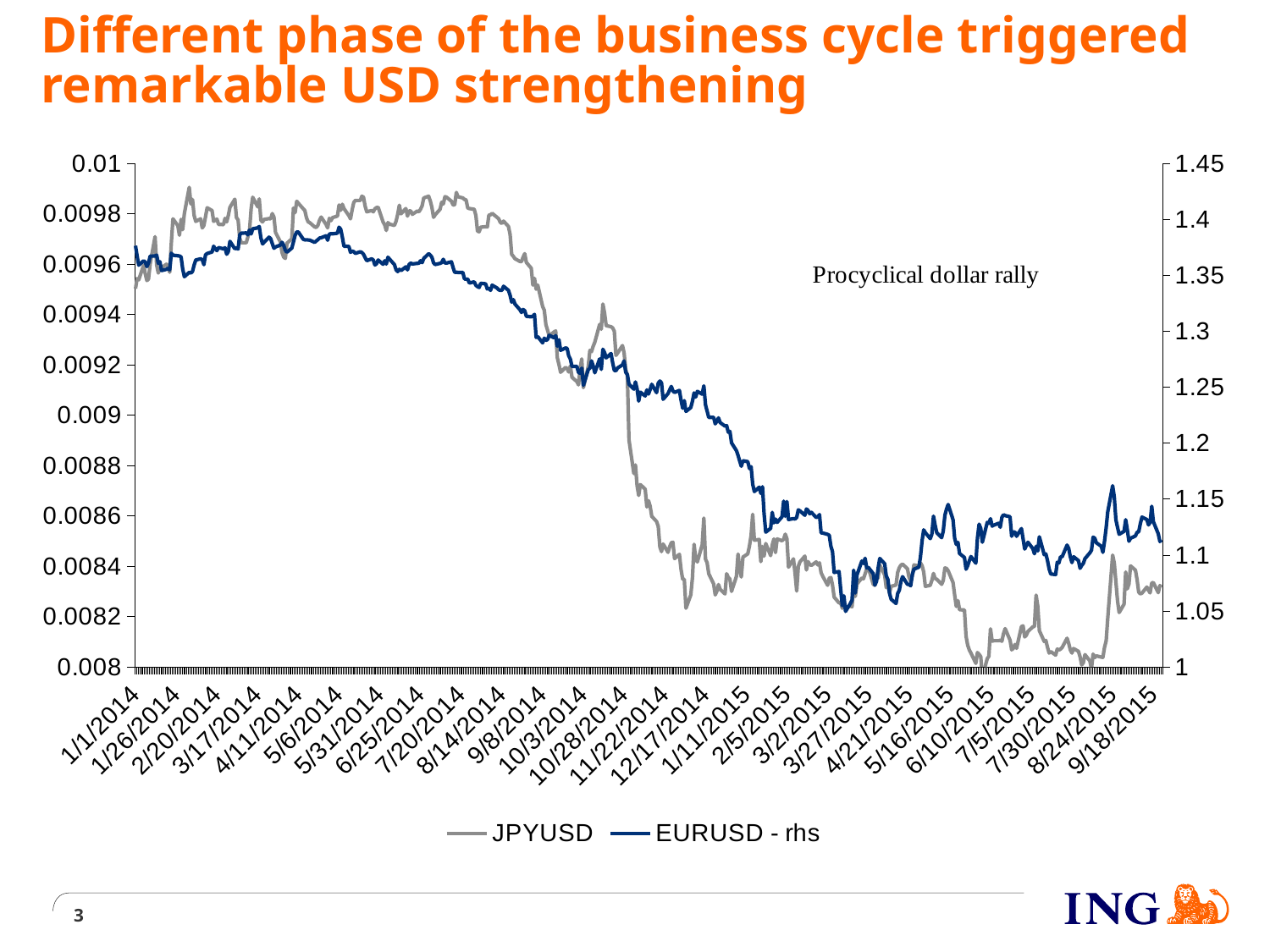
Is the EURUSD value around 3/27/2015 greater or less than 1.15? less How many series does the legend list? 2 Is the JPYUSD value at 1/1/2014 greater or less than 0.009? greater What is the maximum value shown on the right-hand axis? 1.45 Is the EURUSD value at 1/1/2014 greater or less than 1.3? greater What is the text annotation placed inside the chart area? Procyclical dollar rally What kind of chart is shown on the slide? Line chart Overall, does the JPYUSD series rise or fall from 1/1/2014 to 9/18/2015? Fall Overall, does the EURUSD series rise or fall from 1/1/2014 to 9/18/2015? Fall Which series is plotted on the right-hand axis? EURUSD - rhs